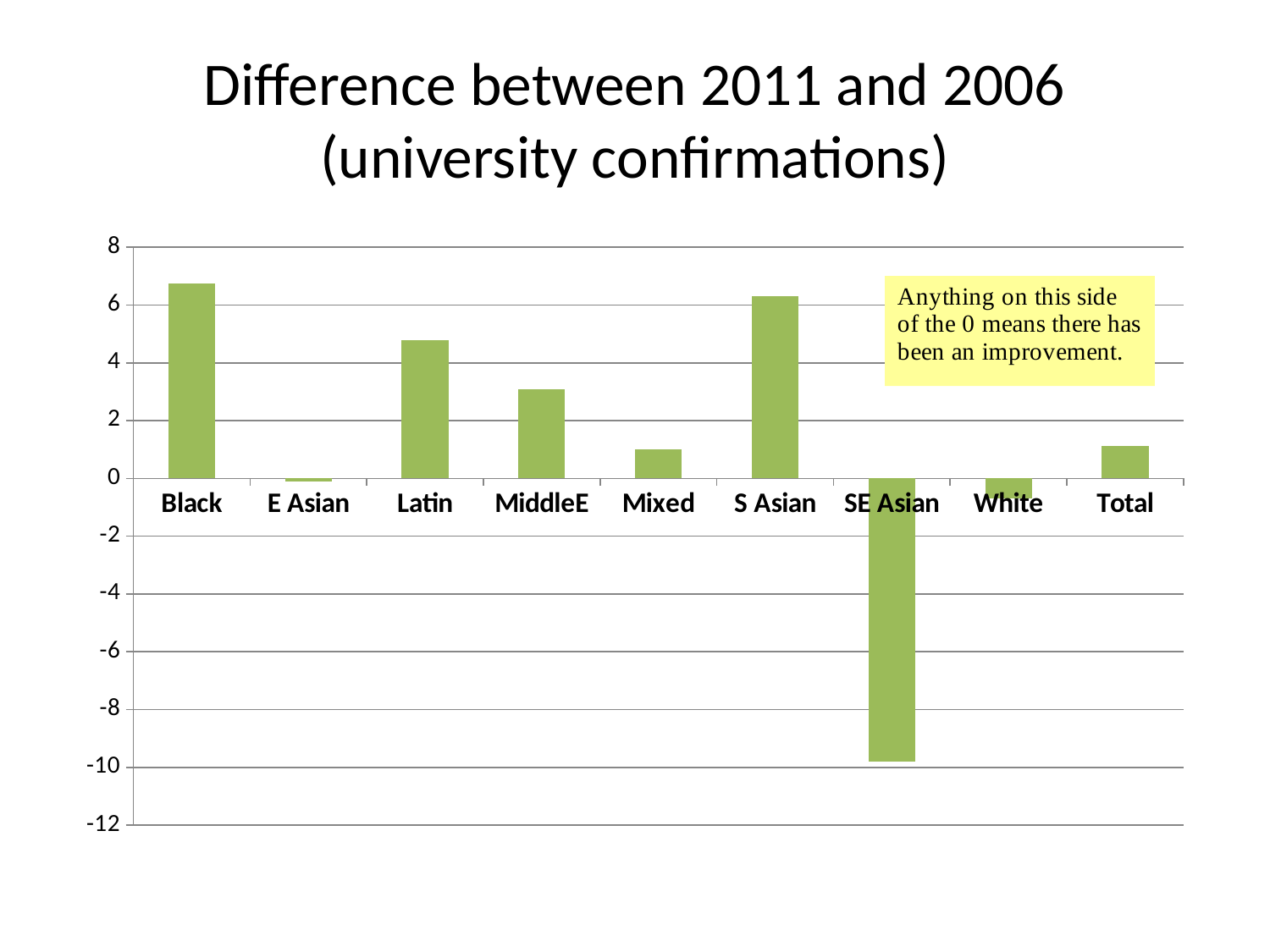
Which category has the lowest value? SE Asian Which category has the highest value? Black Is the value for Mixed greater or less than 2? less How many categories are shown along the x axis? 9 Is the value for Latin greater or less than 4? greater What kind of chart is shown on the slide? bar chart Is the value for MiddleE greater or less than 4? less Which has the larger value, S Asian or Mixed? S Asian What is the title of the chart? Difference between 2011 and 2006 (university confirmations) Which has the larger value, Latin or MiddleE? Latin